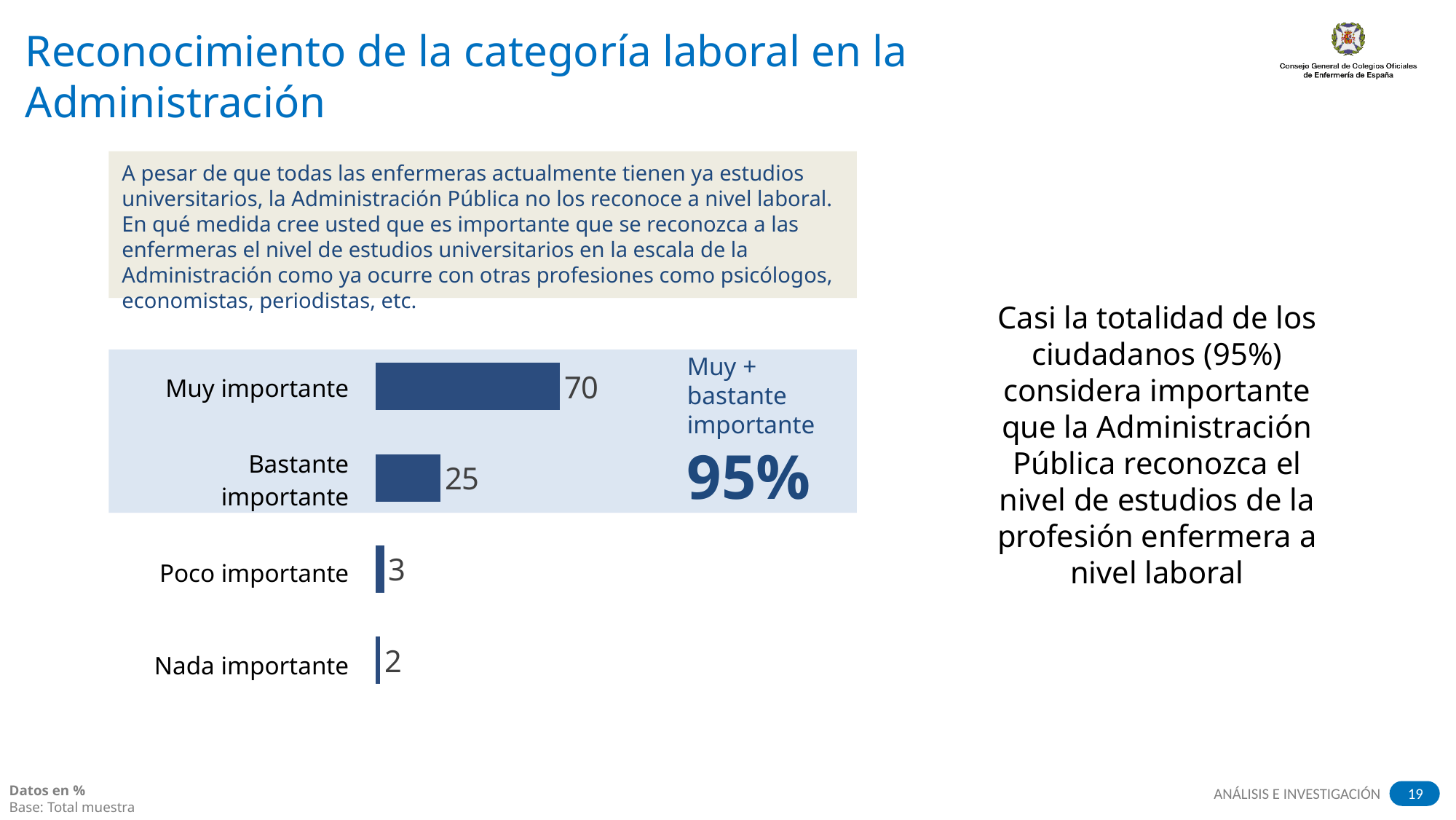
Which is larger, the value for "Poco importante" or "Nada importante"? Poco importante What kind of chart is shown on the slide? Bar chart What is the value for "Nada importante"? 2 How many categories are shown in the chart? 4 What is the value for "Bastante importante"? 25 Which category has the highest value? Muy importante What is the combined percentage shown for "Muy + bastante importante"? 95% Which category has the lowest value? Nada importante What is the value for "Muy importante"? 70 What is the difference between the values for "Muy importante" and "Bastante importante"? 45 Do the values rise or fall going from "Muy importante" down to "Nada importante"? Fall What is the value for "Poco importante"? 3